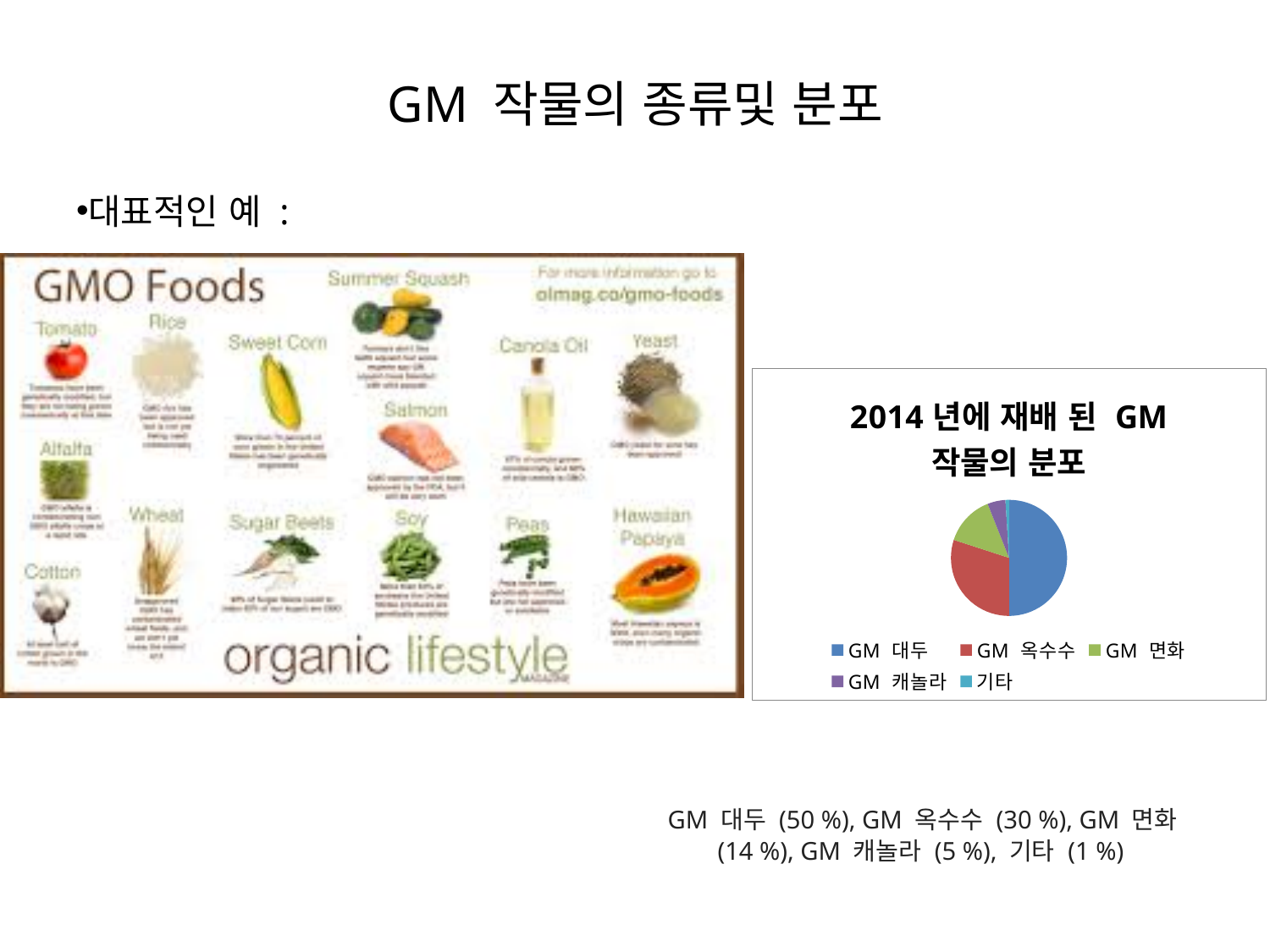
How many series does the legend of the pie chart list? 5 Which category has the largest slice of the pie? GM 대두 What is the value for GM 캐놀라? 5 % What share of the pie does GM 대두 have? 50 % Which is larger, the share of GM 면화 or the share of GM 캐놀라? GM 면화 What kind of chart is shown on the slide? pie chart What is the value for GM 면화? 14 % Which category has the smallest slice of the pie? 기타 What is the title of the pie chart? 2014 년에 재배 된 GM 작물의 분포 What share of the pie does GM 옥수수 have? 30 % What is the difference between the shares of GM 대두 and GM 옥수수? 20 % How many slices does the pie chart have? 5